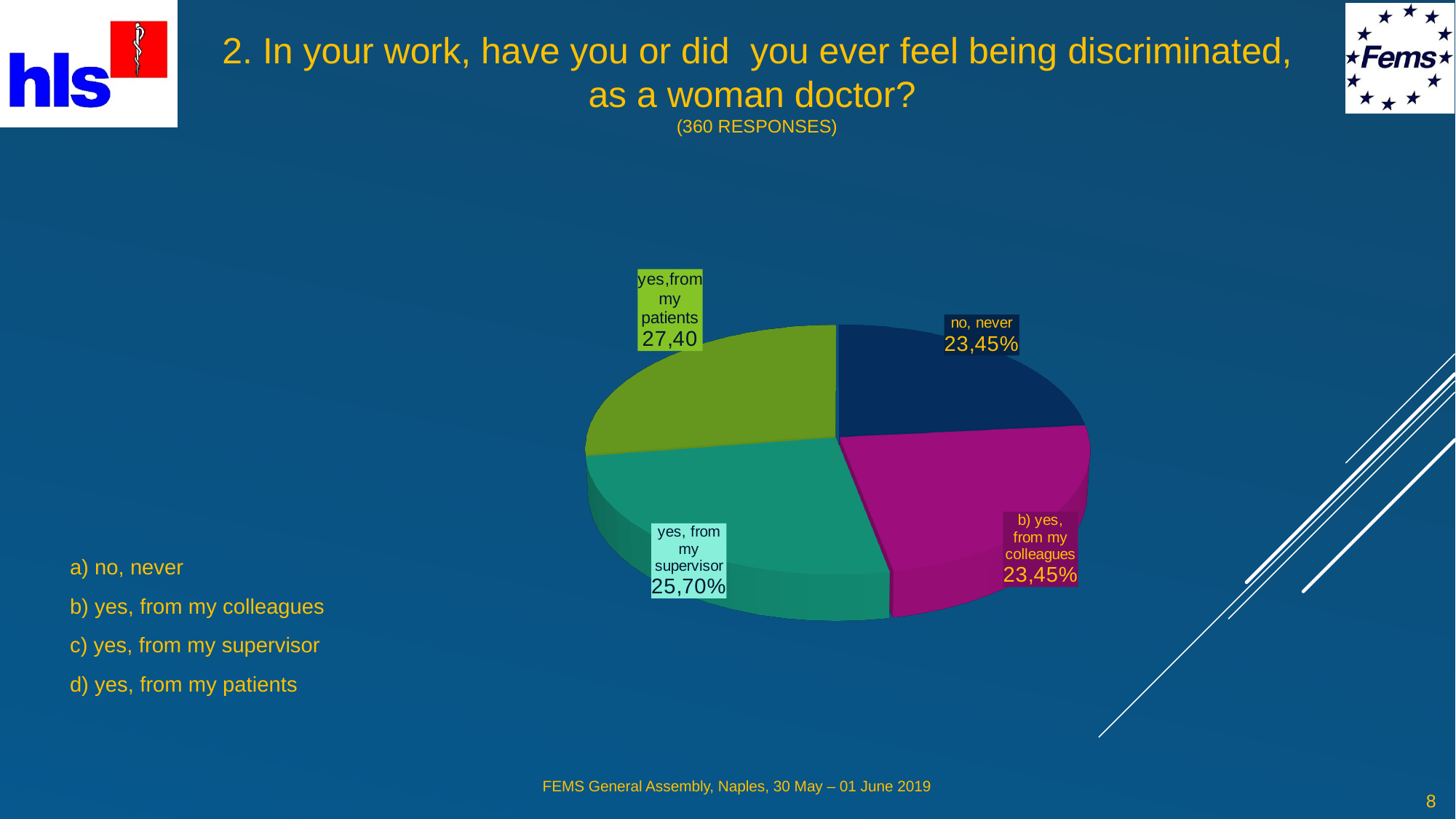
Which response has the largest share of the pie? yes, from my patients What kind of chart is shown on the slide? pie chart What is the difference between the "yes, from my patients" share and the "yes, from my supervisor" share? 1,70 What percentage of respondents answered "b) yes, from my colleagues"? 23,45% What percentage of respondents answered "no, never"? 23,45% What value is shown for the "yes, from my patients" slice? 27,40 How many responses does the slide say the chart is based on? 360 What is the difference between the "yes, from my supervisor" share and the "no, never" share? 2,25 What percentage of respondents answered "yes, from my supervisor"? 25,70% Which is larger: the share for "yes, from my supervisor" or for "b) yes, from my colleagues"? yes, from my supervisor How many slices does the pie chart have? 4 What colour is the "no, never" slice? dark blue